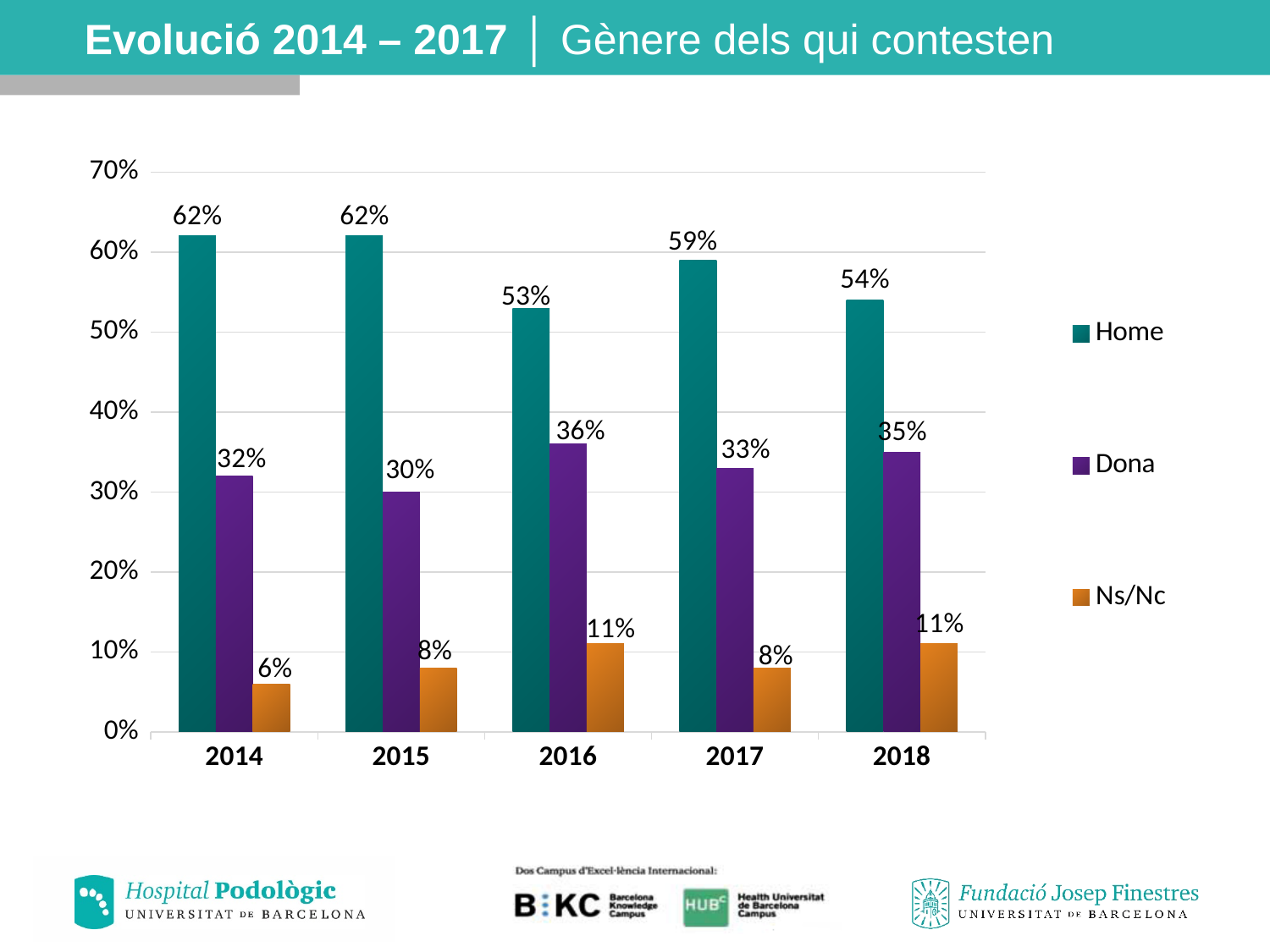
In which year is the Dona value highest? 2016 What is the value for Ns/Nc in 2014? 6% Which is larger in 2015: the Dona value or the Ns/Nc value? Dona Which series is shown in orange in the legend? Ns/Nc What is the difference between the Home and Dona values in 2017? 26% How many years are shown on the x axis? 5 How many series does the legend list? 3 What is the value for Home in 2016? 53% What is the value for Dona in 2018? 35% What kind of chart is shown on the slide? Bar chart Does the Home value rise or fall from 2014 to 2018? Fall In which year is the Home value lowest? 2016